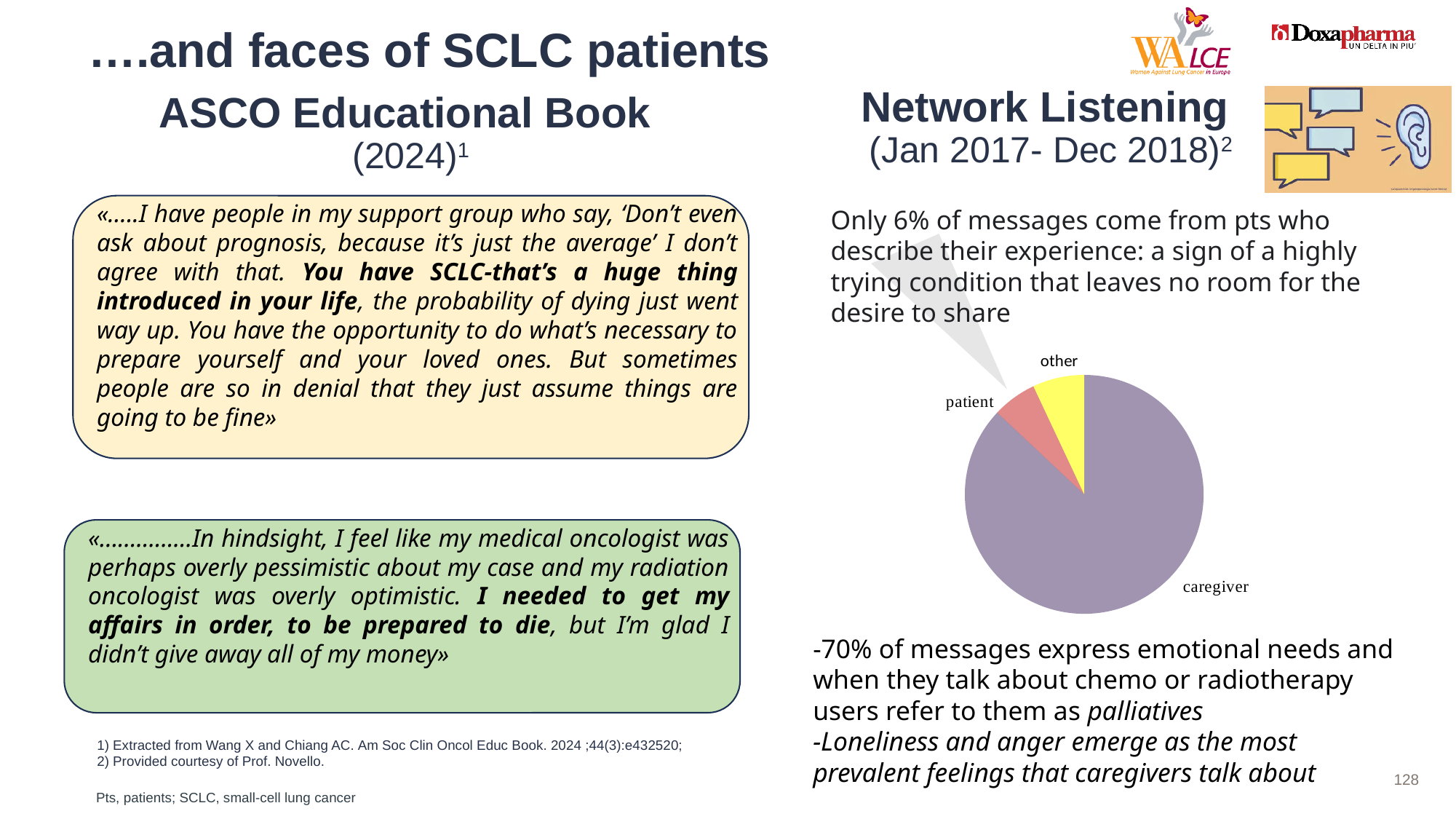
In the pie chart, which slice is larger: caregiver or other? caregiver How many slices does the pie chart have? 3 In the pie chart, which slice is larger: caregiver or patient? caregiver Which category has the largest slice in the pie chart? caregiver What kind of chart is shown under the Network Listening heading? pie chart According to the slide, what share of messages come from patients? 6% What colour is the caregiver slice in the pie chart? purple Which slice of the pie chart does the callout from the '6% of messages' text point to? patient